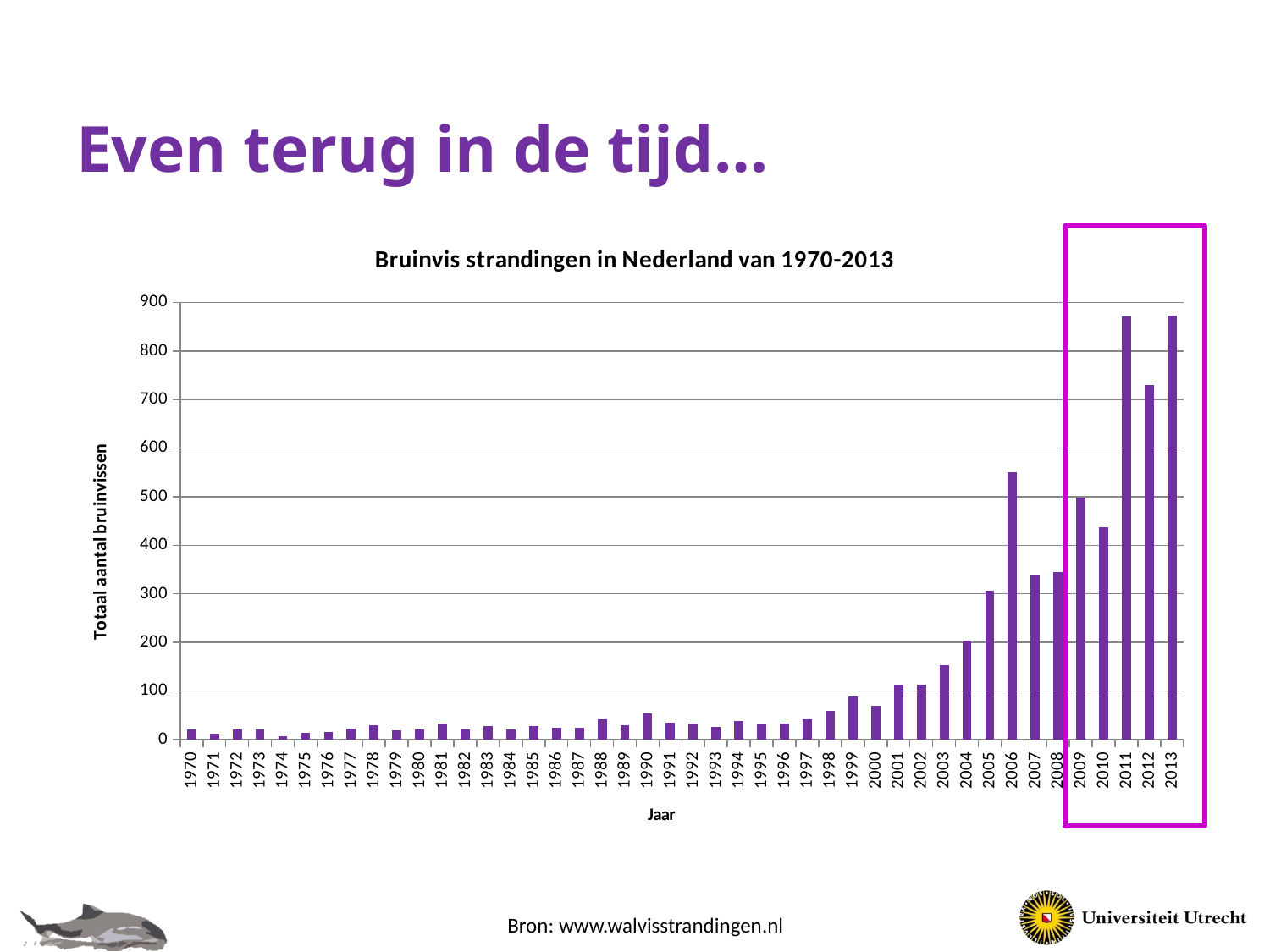
Is the value for 2006 greater or less than 500? greater Overall, do the values rise or fall from 1970 to 2013? rise Is the value for 2007 greater or less than 400? less Is the value for 2012 greater or less than 700? greater Which year has the larger value, 2006 or 2007? 2006 How many years (bars) are plotted on the chart? 44 What is the label of the vertical axis? Totaal aantal bruinvissen What kind of chart is shown on the slide? bar chart Which year has the larger value, 2010 or 2012? 2012 What is the title of the chart? Bruinvis strandingen in Nederland van 1970-2013